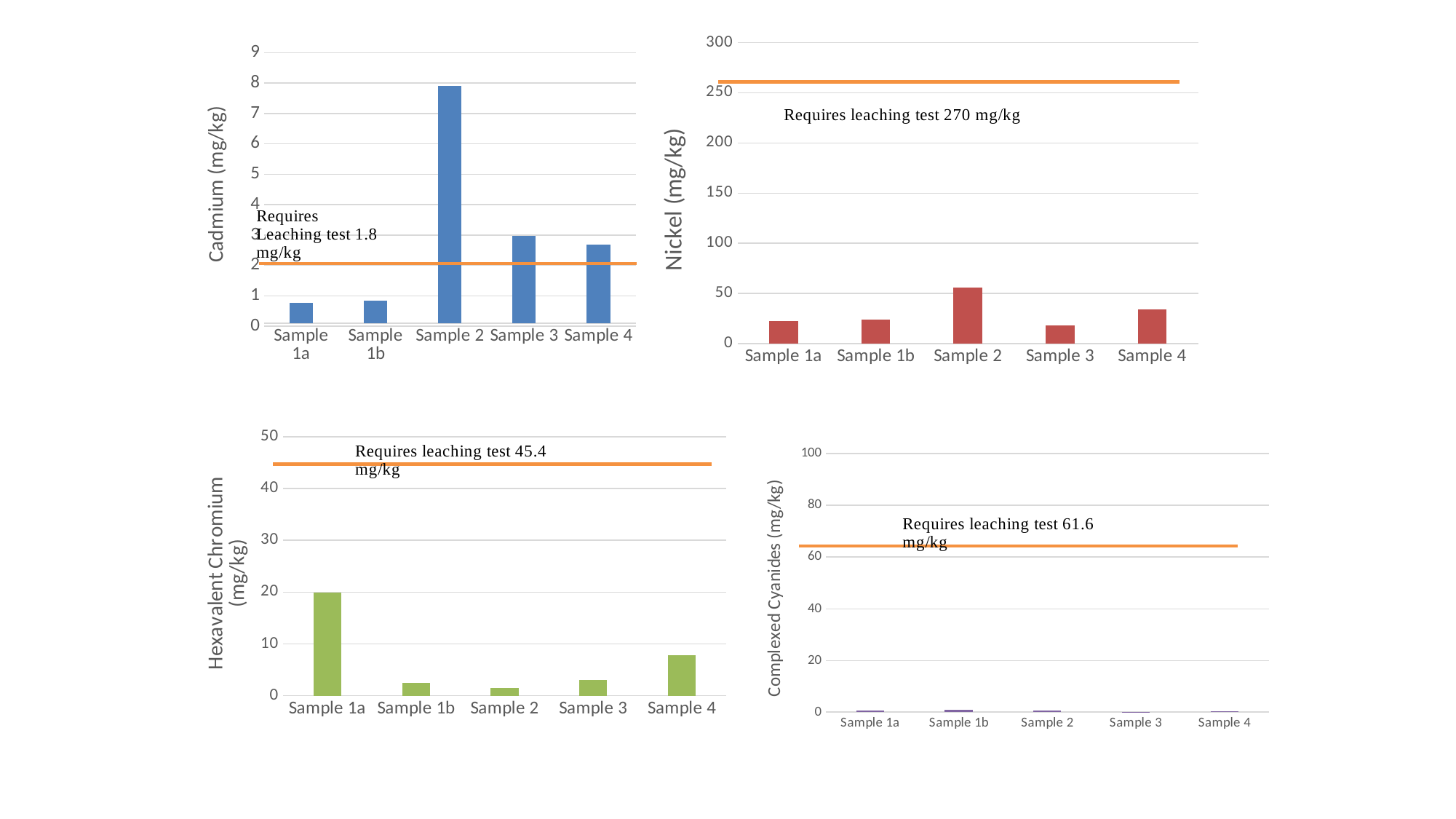
What kind of chart is the Nickel (mg/kg) chart at the top right? bar chart How many samples are shown on the x axis of the Complexed Cyanides (mg/kg) chart at the bottom right? 5 In the Nickel (mg/kg) chart at the top right, what threshold does the text say requires a leaching test? 270 mg/kg In the Cadmium (mg/kg) chart at the top left, is the value for Sample 1a greater or less than 1? less In the Hexavalent Chromium (mg/kg) chart at the bottom left, which sample has the highest value? Sample 1a In the Hexavalent Chromium (mg/kg) chart at the bottom left, is the value for Sample 4 greater or less than 10? less In the Cadmium (mg/kg) chart at the top left, which sample has the highest value? Sample 2 In the Nickel (mg/kg) chart at the top right, is the value for Sample 4 greater or less than 50? less In the Nickel (mg/kg) chart at the top right, which sample has the highest value? Sample 2 In the Hexavalent Chromium (mg/kg) chart at the bottom left, which is larger, the value for Sample 4 or the value for Sample 3? Sample 4 In the Cadmium (mg/kg) chart at the top left, which is larger, the value for Sample 2 or the value for Sample 3? Sample 2